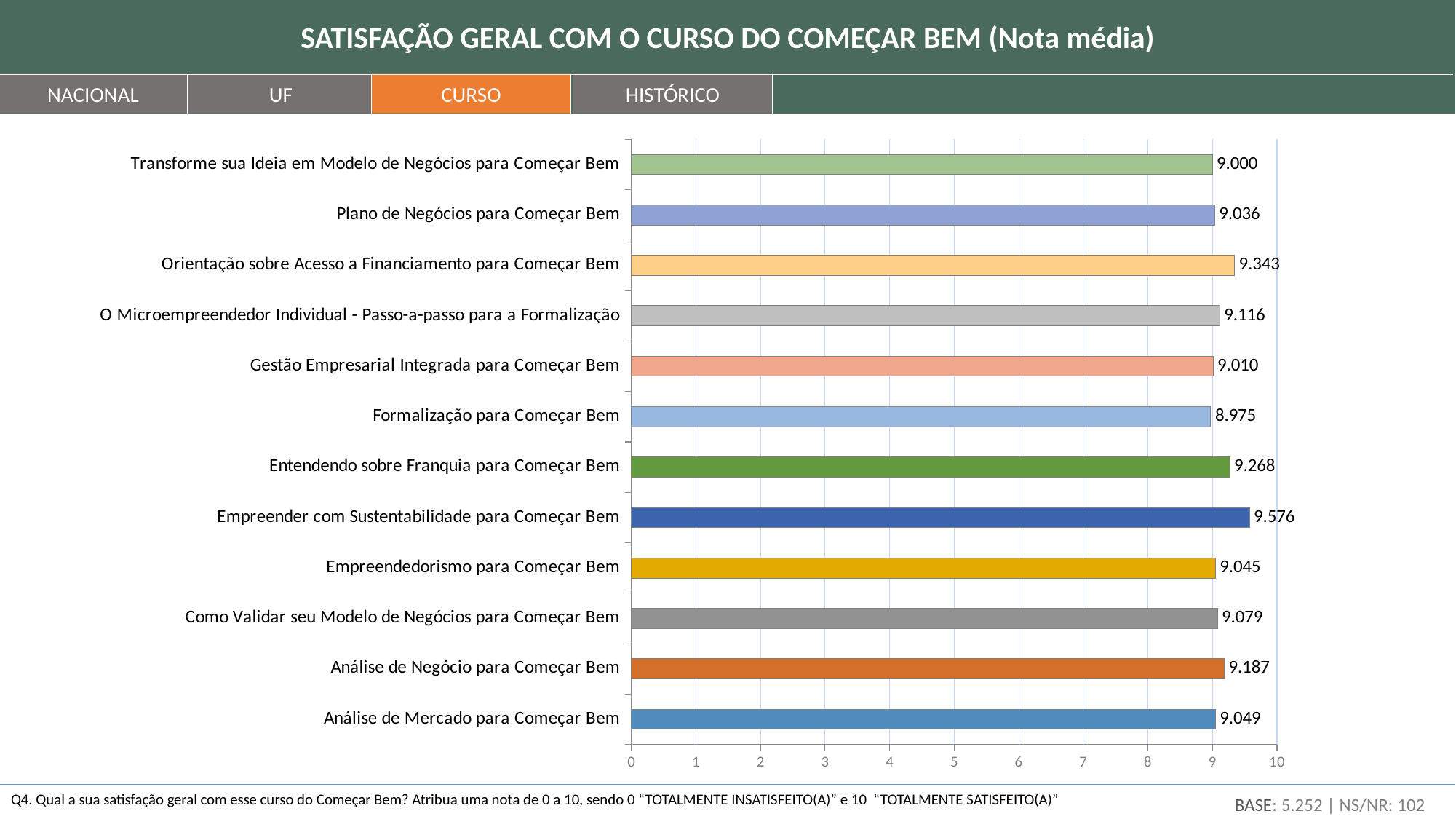
What is the title of the chart? SATISFAÇÃO GERAL COM O CURSO DO COMEÇAR BEM (Nota média) What is the value for Empreender com Sustentabilidade para Começar Bem? 9.576 Is the value for Formalização para Começar Bem greater or less than 9? less Which course has the lowest average score? Formalização para Começar Bem Which is larger: the value for Orientação sobre Acesso a Financiamento para Começar Bem or for Entendendo sobre Franquia para Começar Bem? Orientação sobre Acesso a Financiamento para Começar Bem What is the value for Análise de Negócio para Começar Bem? 9.187 How many courses are shown in the chart? 12 What is the difference between the values for Empreender com Sustentabilidade para Começar Bem and Formalização para Começar Bem? 0.601 Which course has the highest average score? Empreender com Sustentabilidade para Começar Bem What kind of chart is shown on the slide? bar chart What is the value for Formalização para Começar Bem? 8.975 What is the value for Orientação sobre Acesso a Financiamento para Começar Bem? 9.343